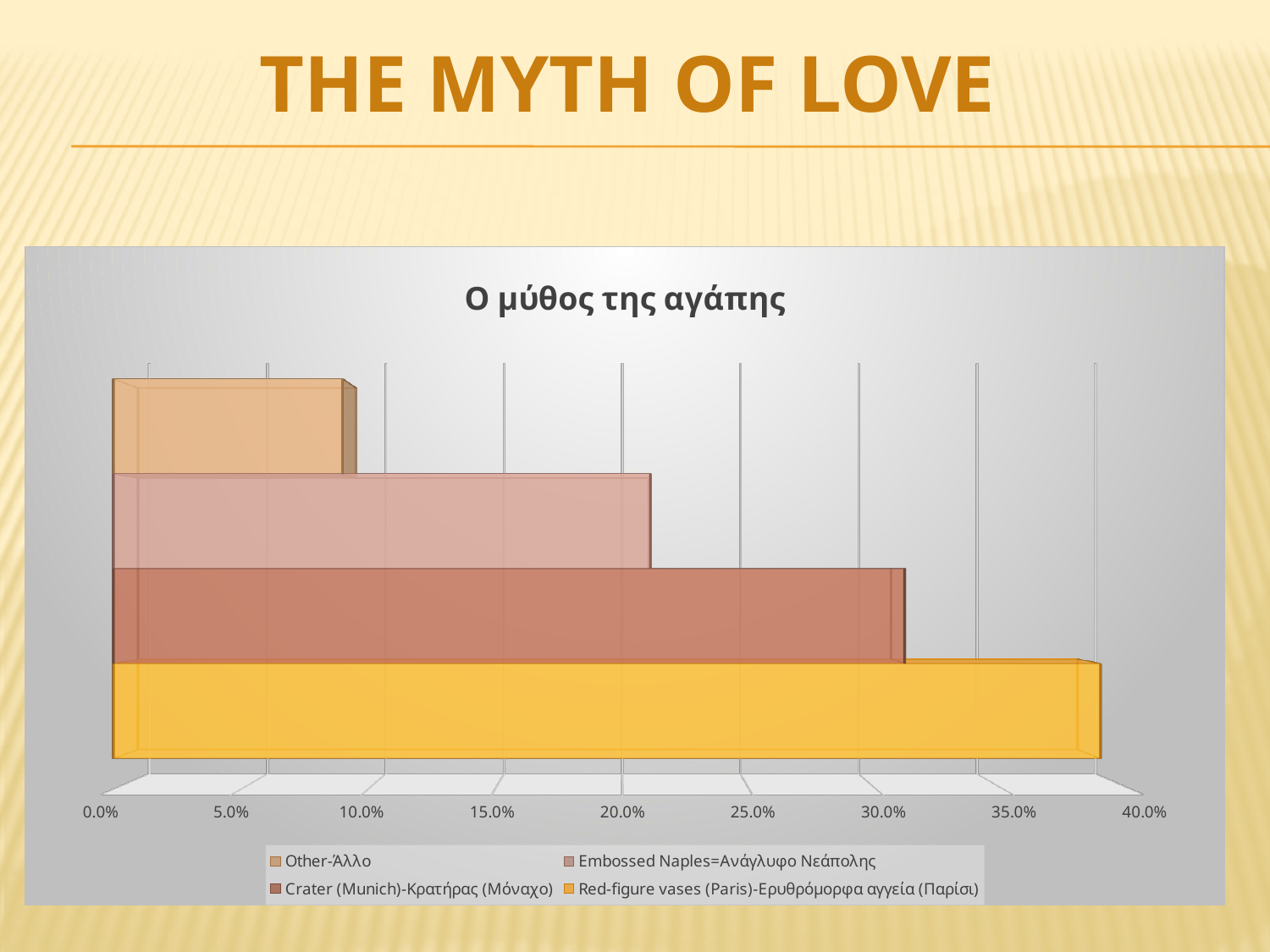
What is the title of the chart? Ο μύθος της αγάπης Which series has the highest value? Red-figure vases (Paris)-Ερυθρόμορφα αγγεία (Παρίσι) Which is larger, the value for Crater (Munich) or the value for Embossed Naples? Crater (Munich) Is the value for Other greater or less than 15.0%? less Is the value for Crater (Munich) greater or less than 25.0%? greater How many series does the legend list? 4 What kind of chart is shown on the slide? bar chart What colour is the bar for Red-figure vases (Paris)? yellow Which is larger, the value for Other or the value for Embossed Naples? Embossed Naples Is the value for Embossed Naples greater or less than 25.0%? less Which series has the lowest value? Other-Άλλο